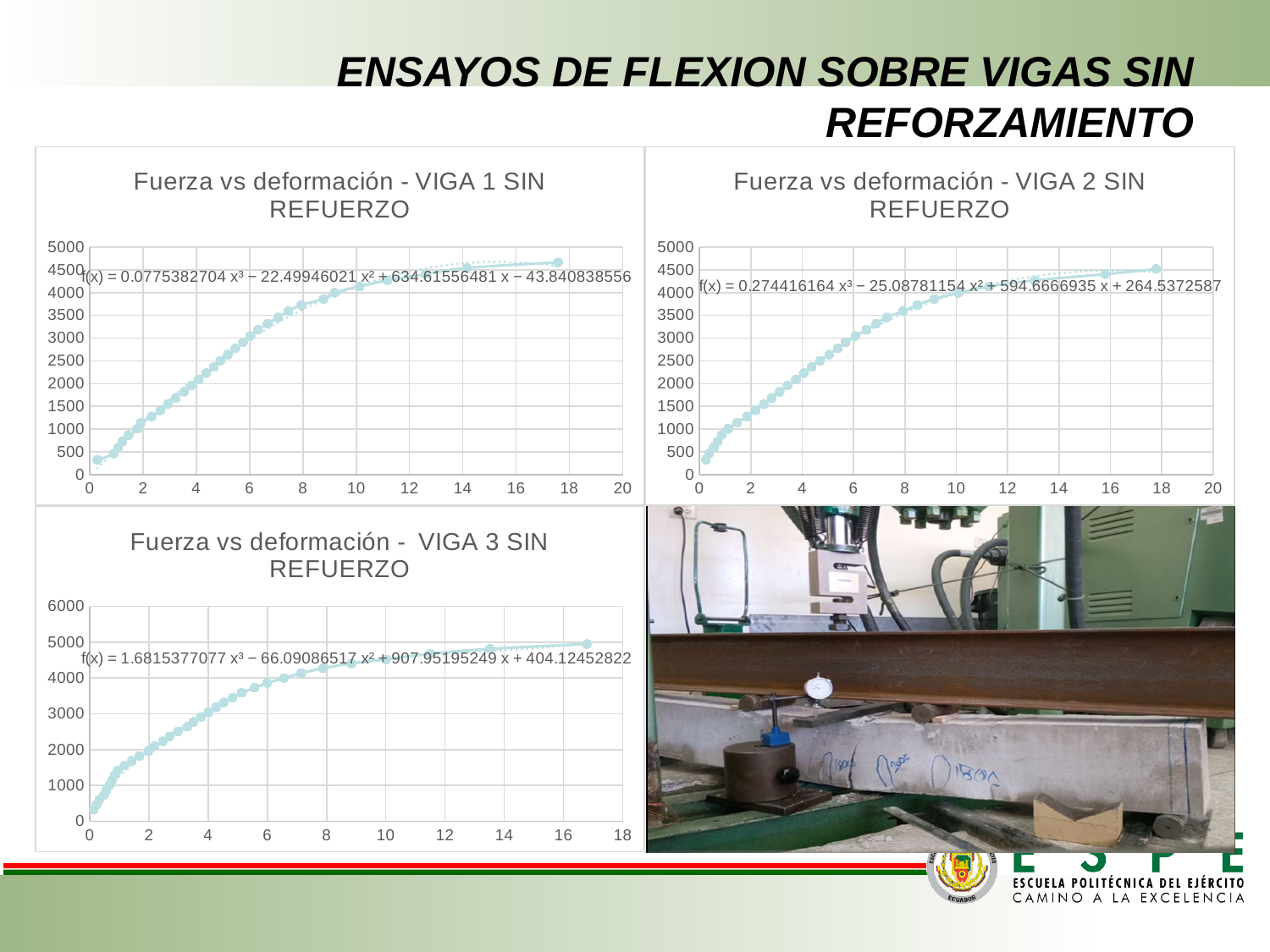
In the chart "Fuerza vs deformación - VIGA 3 SIN REFUERZO", do the values rise or fall along the x axis? Rise What is the maximum value shown on the y axis of the chart "Fuerza vs deformación - VIGA 3 SIN REFUERZO"? 6000 What kind of chart is "Fuerza vs deformación - VIGA 1 SIN REFUERZO"? Scatter chart In the chart "Fuerza vs deformación - VIGA 1 SIN REFUERZO", is the value of the highest point greater or less than 4500? greater In the chart "Fuerza vs deformación - VIGA 3 SIN REFUERZO", is the value of the first (leftmost) point greater or less than 1000? less How many charts are shown on the slide? 3 In the chart "Fuerza vs deformación - VIGA 2 SIN REFUERZO", do the values rise or fall as the x axis increases? Rise In the chart "Fuerza vs deformación - VIGA 1 SIN REFUERZO", is the value of the first (leftmost) point greater or less than 500? less What is the title of the chart in the top-right of the slide? Fuerza vs deformación - VIGA 2 SIN REFUERZO